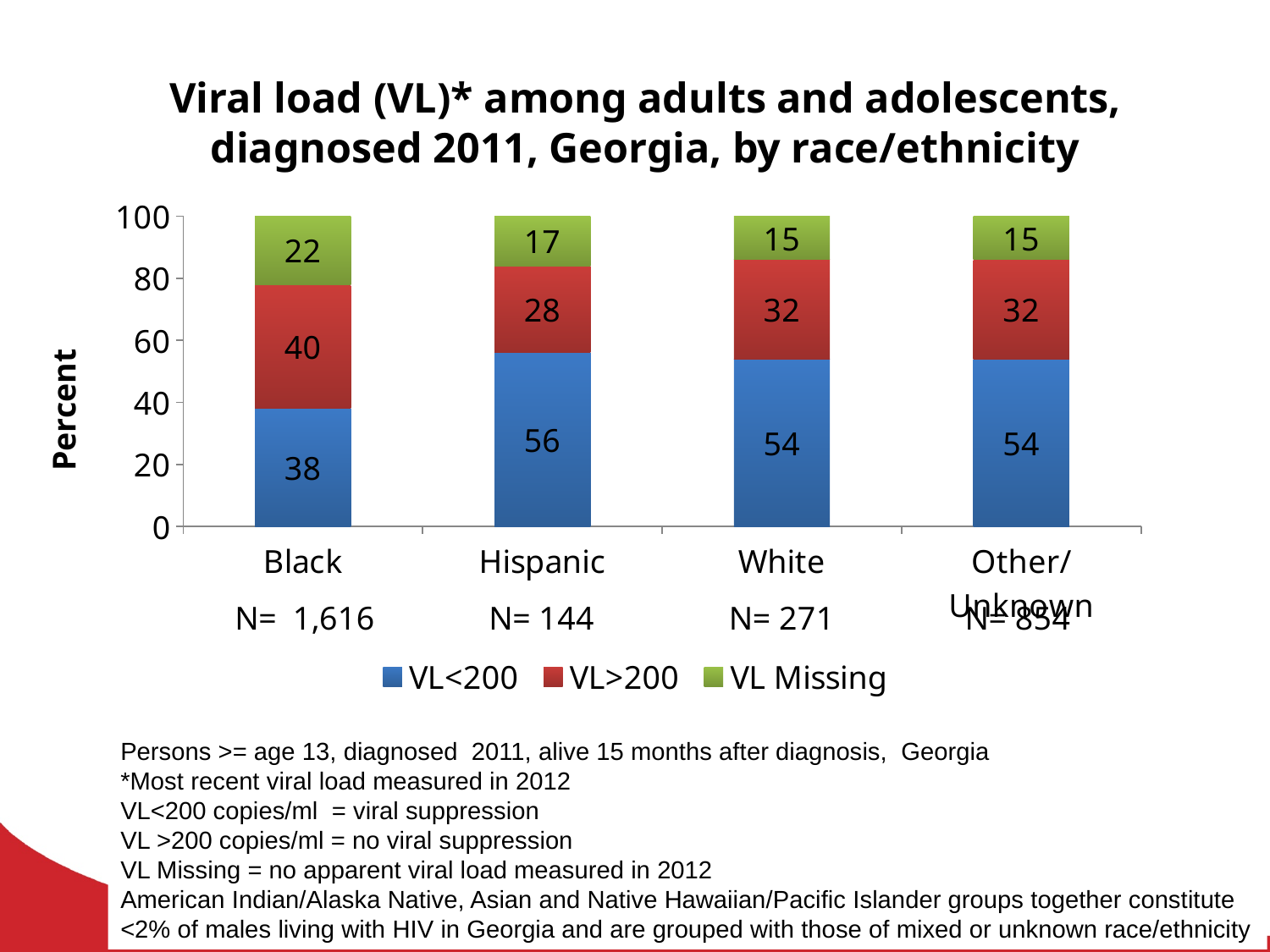
Which group has the highest VL Missing value? Black What is the label on the y axis? Percent What kind of chart is shown on the slide? Stacked bar chart Which race/ethnicity group has the lowest VL<200 value? Black What is the VL>200 value for White persons? 32 What is the VL Missing value for Hispanic persons? 17 How many series does the legend list? 3 What is the difference between the VL>200 values for Black and Hispanic persons? 12 How many race/ethnicity categories are shown on the x axis? 4 Is the VL<200 value larger for White or for Black persons? White Which race/ethnicity group has the highest VL<200 value? Hispanic What percentage of Black persons had VL<200? 38